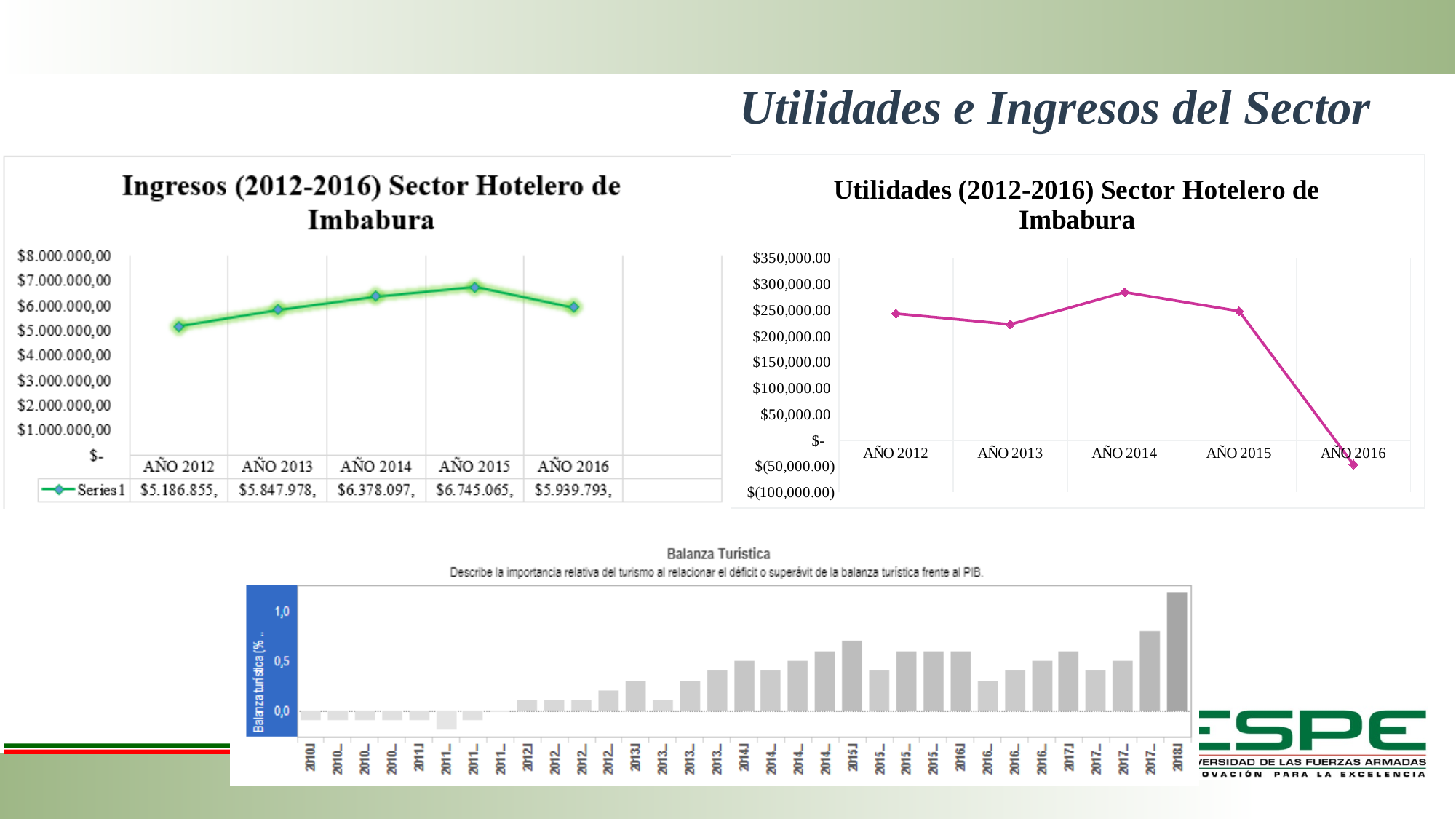
In the 'Ingresos (2012-2016) Sector Hotelero de Imbabura' chart, is the value for AÑO 2012 greater or less than $6.000.000,00? less In the 'Ingresos (2012-2016) Sector Hotelero de Imbabura' chart, which year has the highest income? AÑO 2015 In the 'Ingresos (2012-2016) Sector Hotelero de Imbabura' chart, which year has the lowest income? AÑO 2012 What kind of chart is the 'Balanza Turística' chart at the bottom of the slide? bar chart In the 'Ingresos (2012-2016) Sector Hotelero de Imbabura' chart, is the value for AÑO 2014 greater or less than $6.000.000,00? greater In the 'Utilidades (2012-2016) Sector Hotelero de Imbabura' chart, which year has the lowest profit? AÑO 2016 In the 'Ingresos (2012-2016) Sector Hotelero de Imbabura' chart, how many series does the legend list? 1 In the 'Utilidades (2012-2016) Sector Hotelero de Imbabura' chart, is the value for AÑO 2014 greater or less than $250,000.00? greater In the 'Ingresos (2012-2016) Sector Hotelero de Imbabura' chart, how many years are plotted? 5 In the 'Utilidades (2012-2016) Sector Hotelero de Imbabura' chart, which year has the highest profit? AÑO 2014 In the 'Utilidades (2012-2016) Sector Hotelero de Imbabura' chart, which is larger, the value for AÑO 2014 or AÑO 2013? AÑO 2014